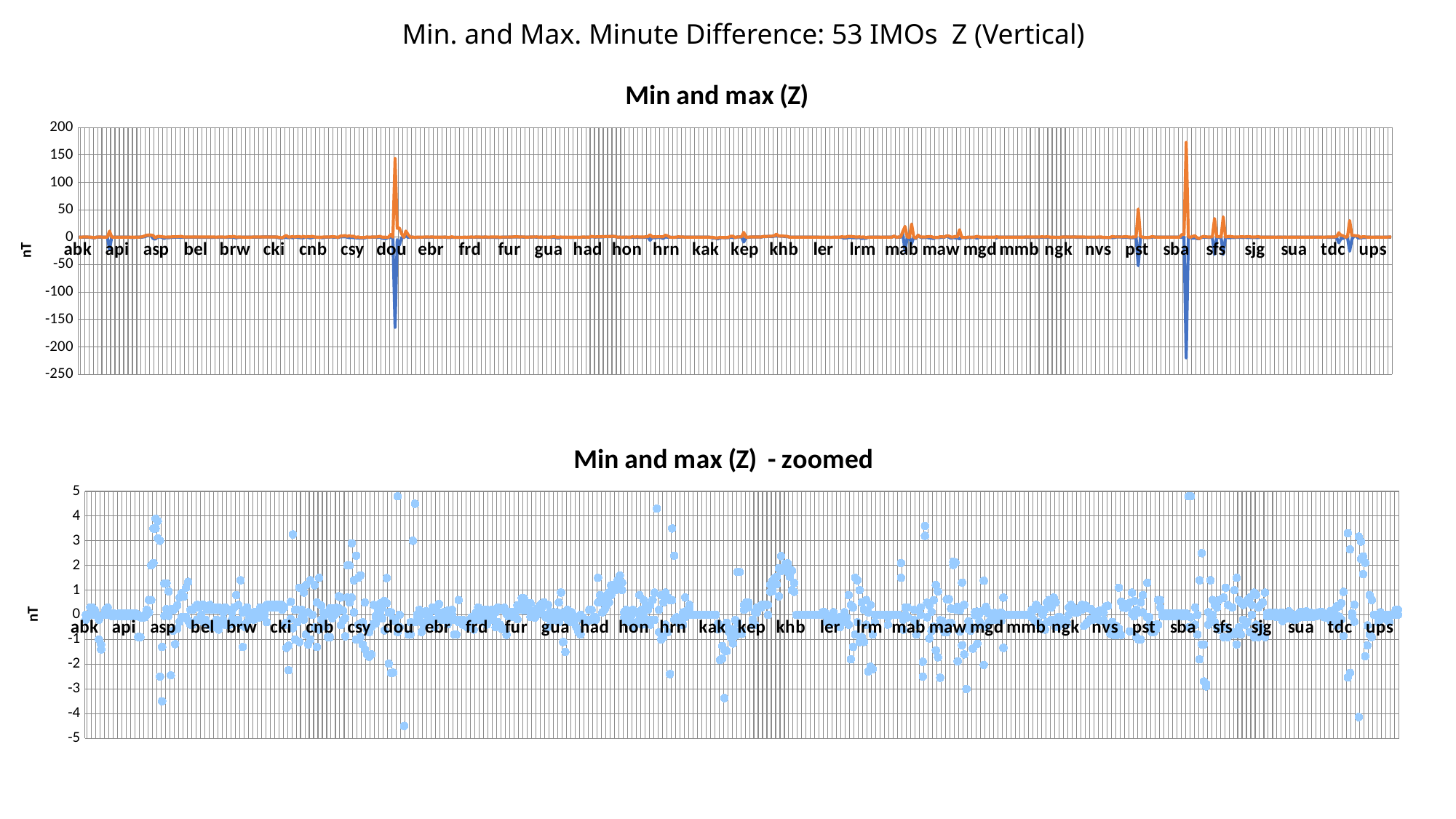
What kind of chart is the top chart, 'Min and max (Z)'? line chart In the top chart 'Min and max (Z)', is the lowest blue value at dou greater or less than -100? less What is the title of the bottom chart? Min and max (Z) - zoomed What is the title of the top chart? Min and max (Z) In the top chart 'Min and max (Z)', is the orange peak at dou greater or less than 100? greater What kind of chart is the bottom chart, 'Min and max (Z) - zoomed'? scatter chart In the top chart 'Min and max (Z)', which station has the larger orange peak, pst or sfs? pst